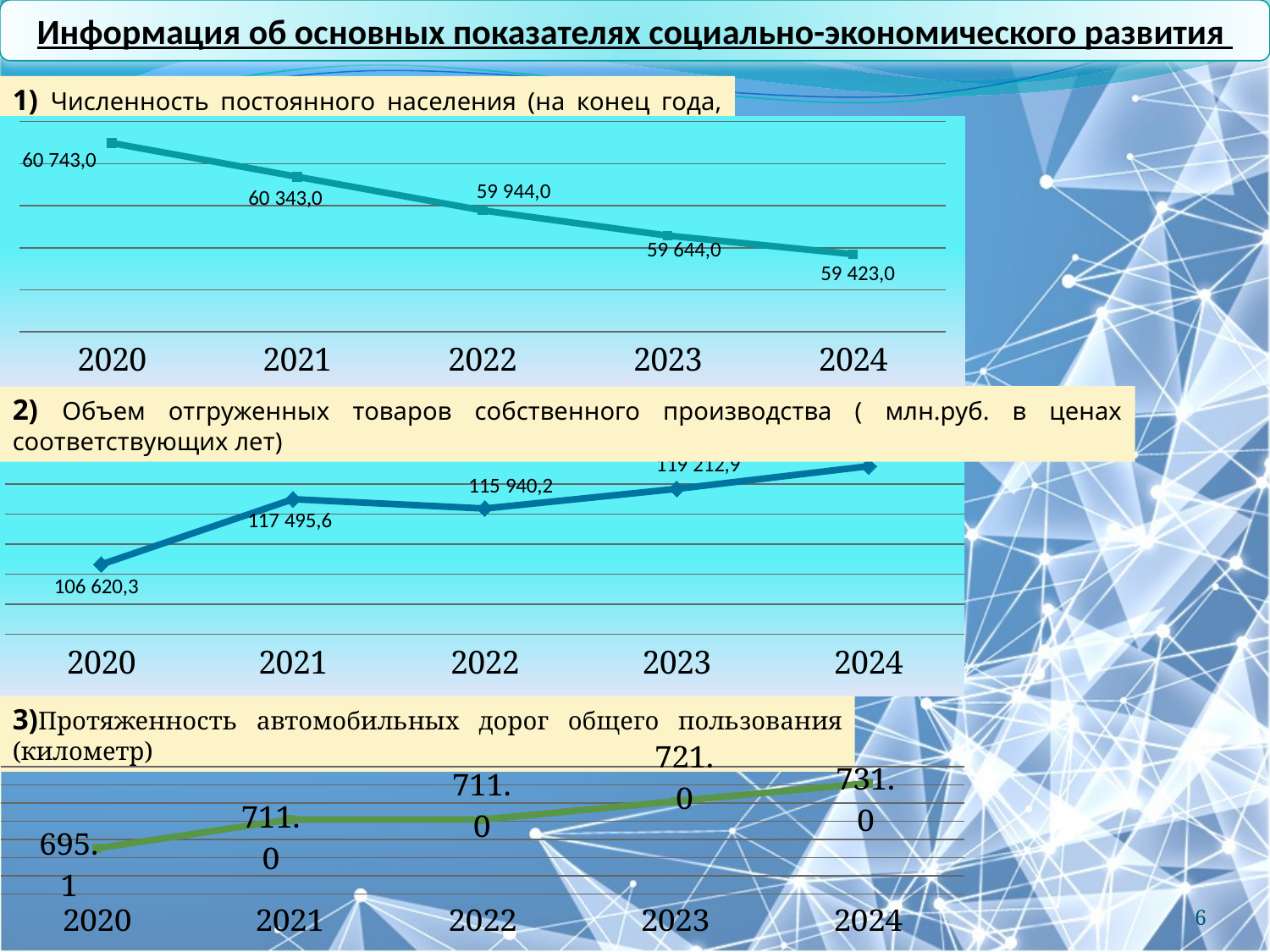
In the third chart (Протяженность автомобильных дорог общего пользования), what is the value for 2020? 695.1 In the second chart (Объем отгруженных товаров собственного производства), which is larger, the value for 2021 or the value for 2022? 2021 In the second chart (Объем отгруженных товаров собственного производства), what is the value for 2020? 106 620,3 In the first chart (Численность постоянного населения), which year has the lowest value? 2024 In the first chart (Численность постоянного населения), what is the value for 2024? 59 423,0 In the second chart (Объем отгруженных товаров собственного производства), which year has the highest value? 2024 How many years are plotted on the x axis of the third chart (Протяженность автомобильных дорог общего пользования)? 5 In the third chart (Протяженность автомобильных дорог общего пользования), what is the difference between the 2024 and 2020 values? 35.9 In the first chart (Численность постоянного населения), what is the difference between the 2020 and 2024 values? 1 320,0 In the first chart (Численность постоянного населения), do the values rise or fall from 2020 to 2024? fall In the second chart (Объем отгруженных товаров собственного производства), what is the value for 2021? 117 495,6 In the first chart (Численность постоянного населения), what is the value for 2020? 60 743,0